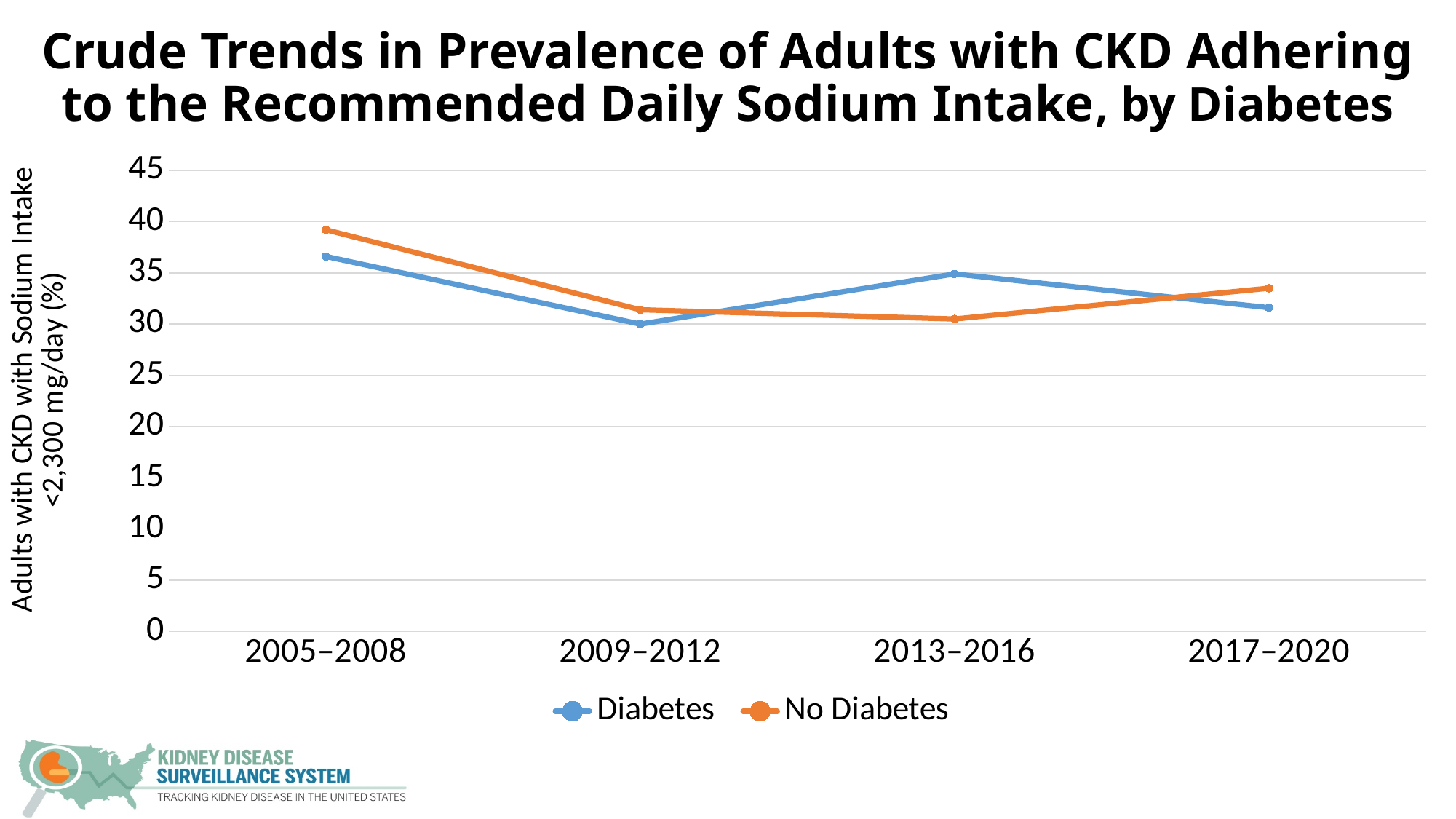
In which period is the No Diabetes series at its highest? 2005–2008 Which series has the higher value in 2013–2016, Diabetes or No Diabetes? Diabetes Is the value for Diabetes in 2005–2008 greater or less than 35? greater How many time periods are shown on the x axis? 4 In which period is the Diabetes series at its highest? 2005–2008 Which colour is used for the No Diabetes series? Orange Which series has the higher value in 2005–2008, Diabetes or No Diabetes? No Diabetes In which period is the Diabetes series at its lowest? 2009–2012 How many series does the legend list? 2 What kind of chart is shown on the slide? Line chart Does the Diabetes series rise or fall from 2005–2008 to 2009–2012? fall Is the value for No Diabetes in 2005–2008 greater or less than 40? less